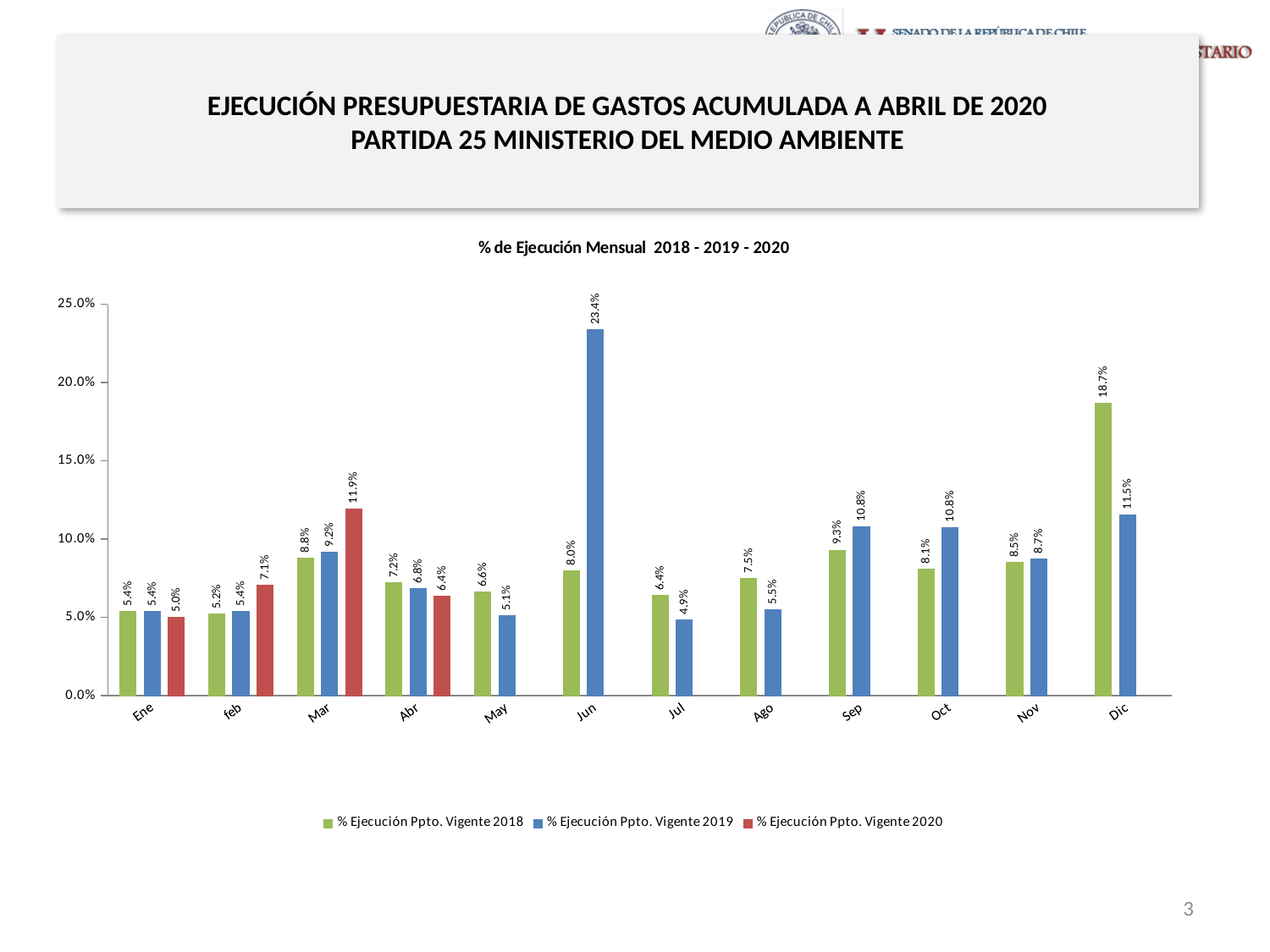
What is the value of % Ejecución Ppto. Vigente 2018 for Dic? 18.7% How many months have a value for % Ejecución Ppto. Vigente 2020? 4 What is the title of the chart? % de Ejecución Mensual 2018 - 2019 - 2020 What type of chart is shown on the slide? Bar chart What is the value of % Ejecución Ppto. Vigente 2020 for Mar? 11.9% How many series does the legend list? 3 What is the difference between the 2019 and 2018 values for Jun? 15.4% Which month has the highest value for % Ejecución Ppto. Vigente 2019? Jun Which is larger for Abr: the 2018 value or the 2020 value? 2018 value Which month has the lowest value for % Ejecución Ppto. Vigente 2019? Jul What is the difference between the 2020 and 2018 values for Mar? 3.1% What is the value of % Ejecución Ppto. Vigente 2019 for Jun? 23.4%